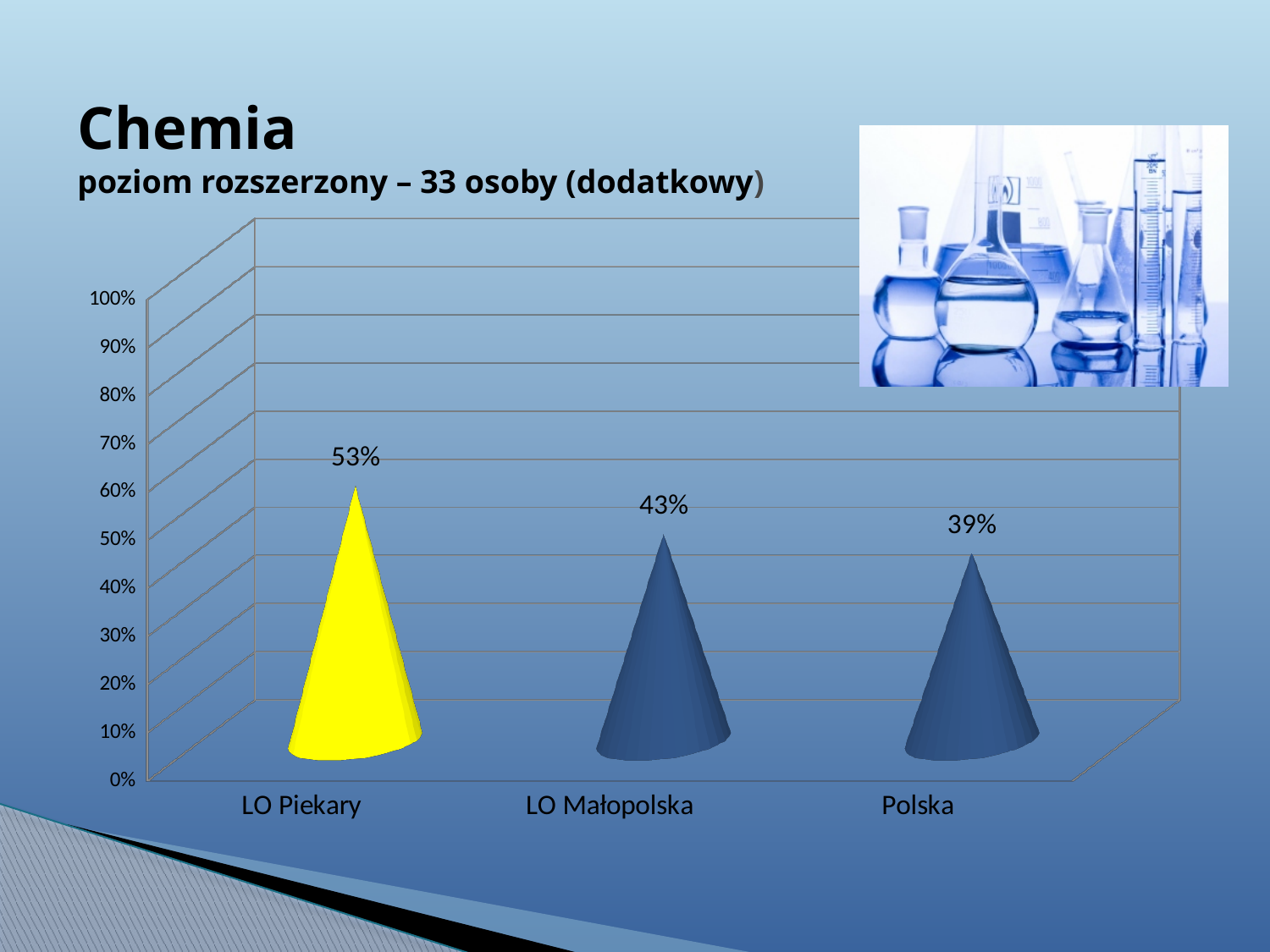
What is the value for LO Piekary? 53% What is the value for LO Małopolska? 43% How many categories are shown on the chart? 3 What is the difference between the values for LO Piekary and Polska? 14% Is the value for LO Piekary greater or less than 50%? greater Which is larger, the value for LO Piekary or the value for LO Małopolska? LO Piekary Which category has the highest value? LO Piekary What is the value for Polska? 39% Which category has the lowest value? Polska Do the values rise or fall from left to right along the x axis? fall What kind of chart is shown on the slide? bar chart What is the difference between the values for LO Małopolska and Polska? 4%